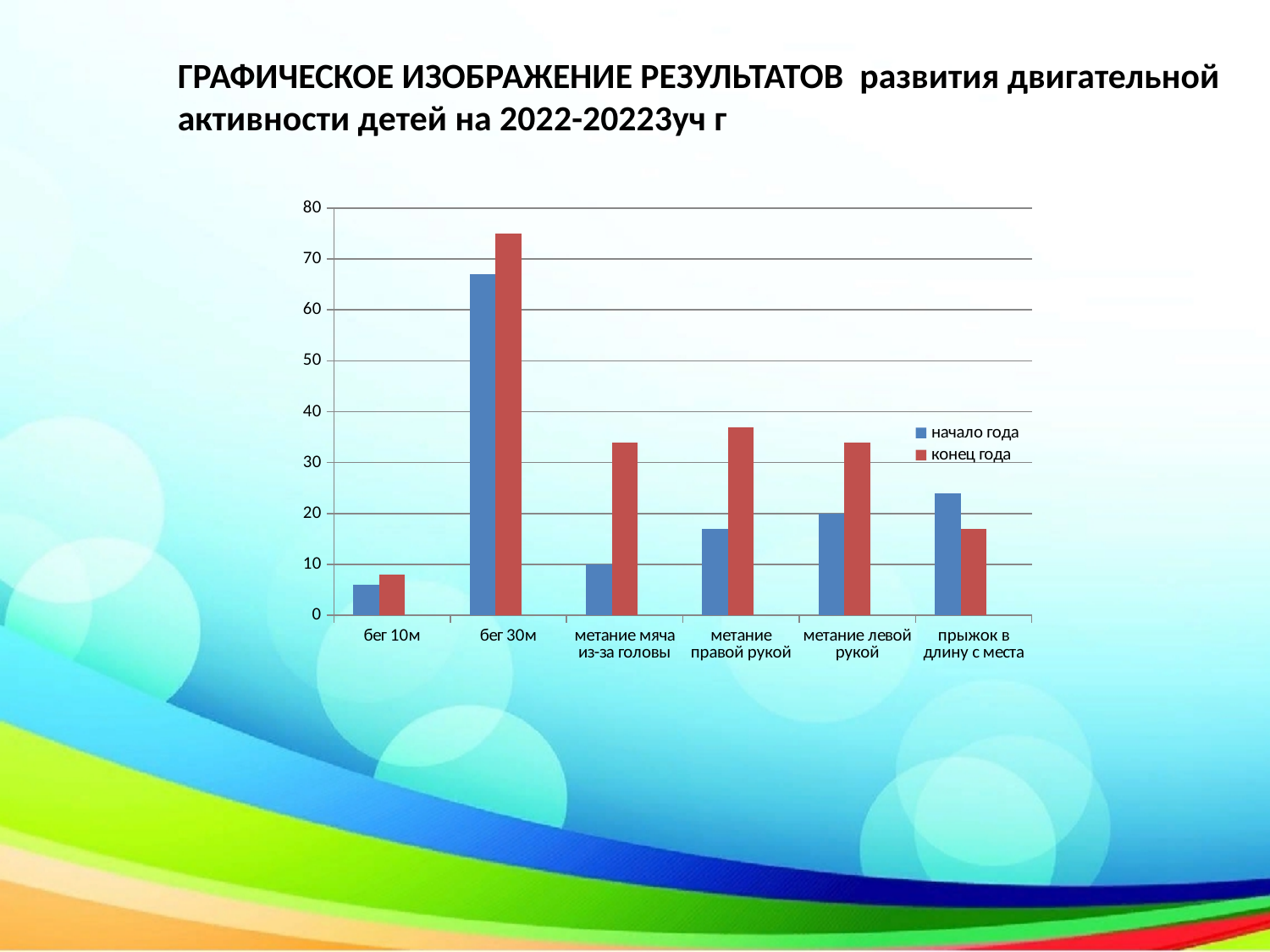
Is the value for 'бег 30м' in the series 'конец года' greater or less than 70? greater Is the value for 'бег 30м' in the series 'начало года' greater or less than 60? greater Which category has the lowest value for the series 'начало года'? бег 10м Is the value for 'метание правой рукой' in the series 'начало года' greater or less than 20? less Which category has the highest value for the series 'конец года'? бег 30м Which colour represents the series 'конец года' in the chart? red For 'прыжок в длину с места', which series has the larger value, 'начало года' or 'конец года'? начало года What kind of chart is shown on the slide? bar chart How many series does the chart's legend list? 2 How many categories are shown on the x axis of the chart? 6